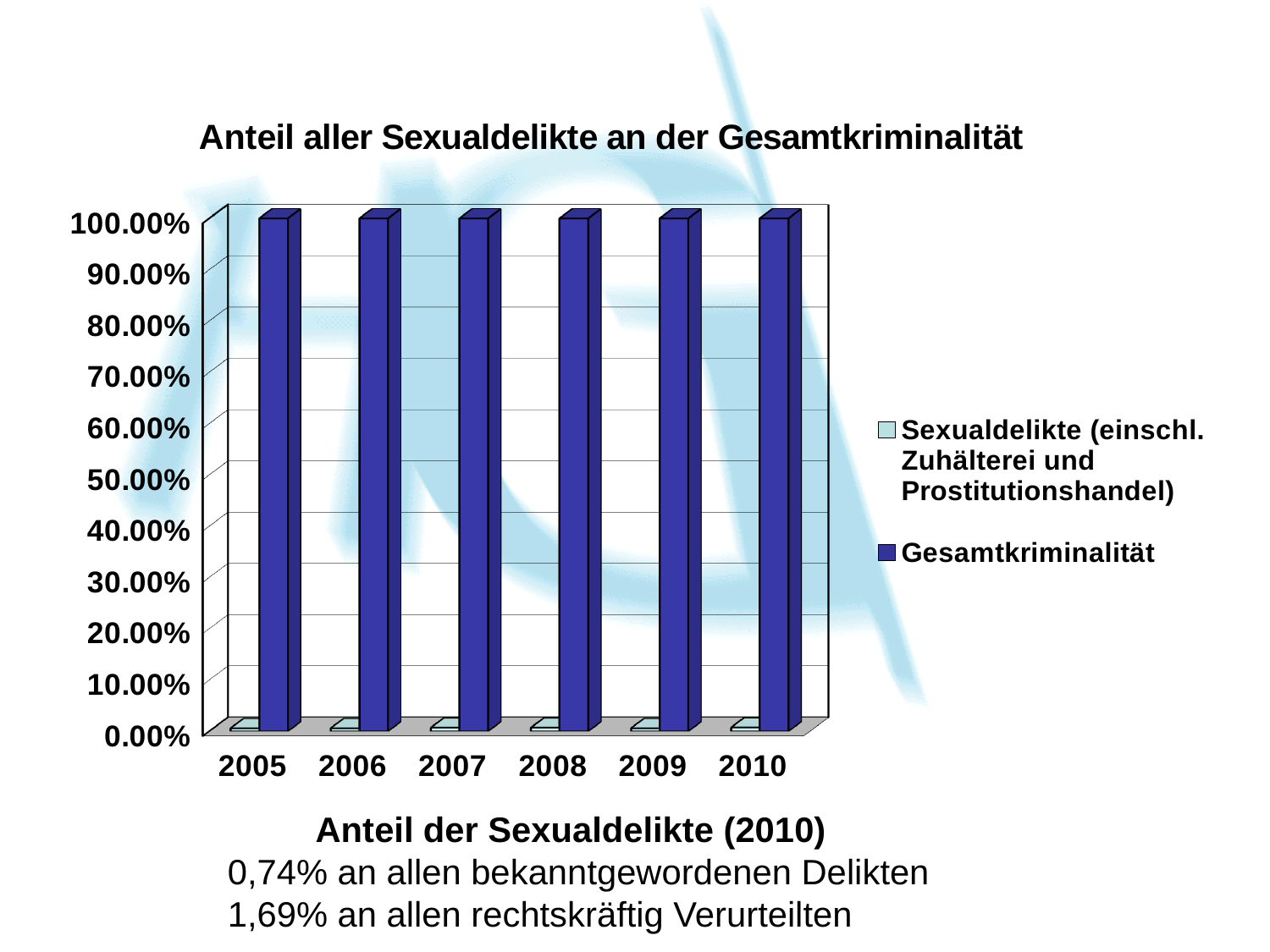
How many series does the legend list? 2 Is the value for Sexualdelikte (einschl. Zuhälterei und Prostitutionshandel) in 2008 greater or less than 10.00%? less What colour are the bars for Gesamtkriminalität? dark blue Do the values for Gesamtkriminalität rise, fall or stay the same from 2005 to 2010? stay the same Which series has the larger value in 2009, Sexualdelikte or Gesamtkriminalität? Gesamtkriminalität What is the title of the chart? Anteil aller Sexualdelikte an der Gesamtkriminalität How many years are shown on the x axis of the chart? 6 What type of chart is shown on the slide? bar chart Is the value for Gesamtkriminalität in 2007 greater or less than 90.00%? greater What is the first year shown on the x axis? 2005 What is the value for Gesamtkriminalität in 2005? 100.00% What is the value for Gesamtkriminalität in 2010? 100.00%